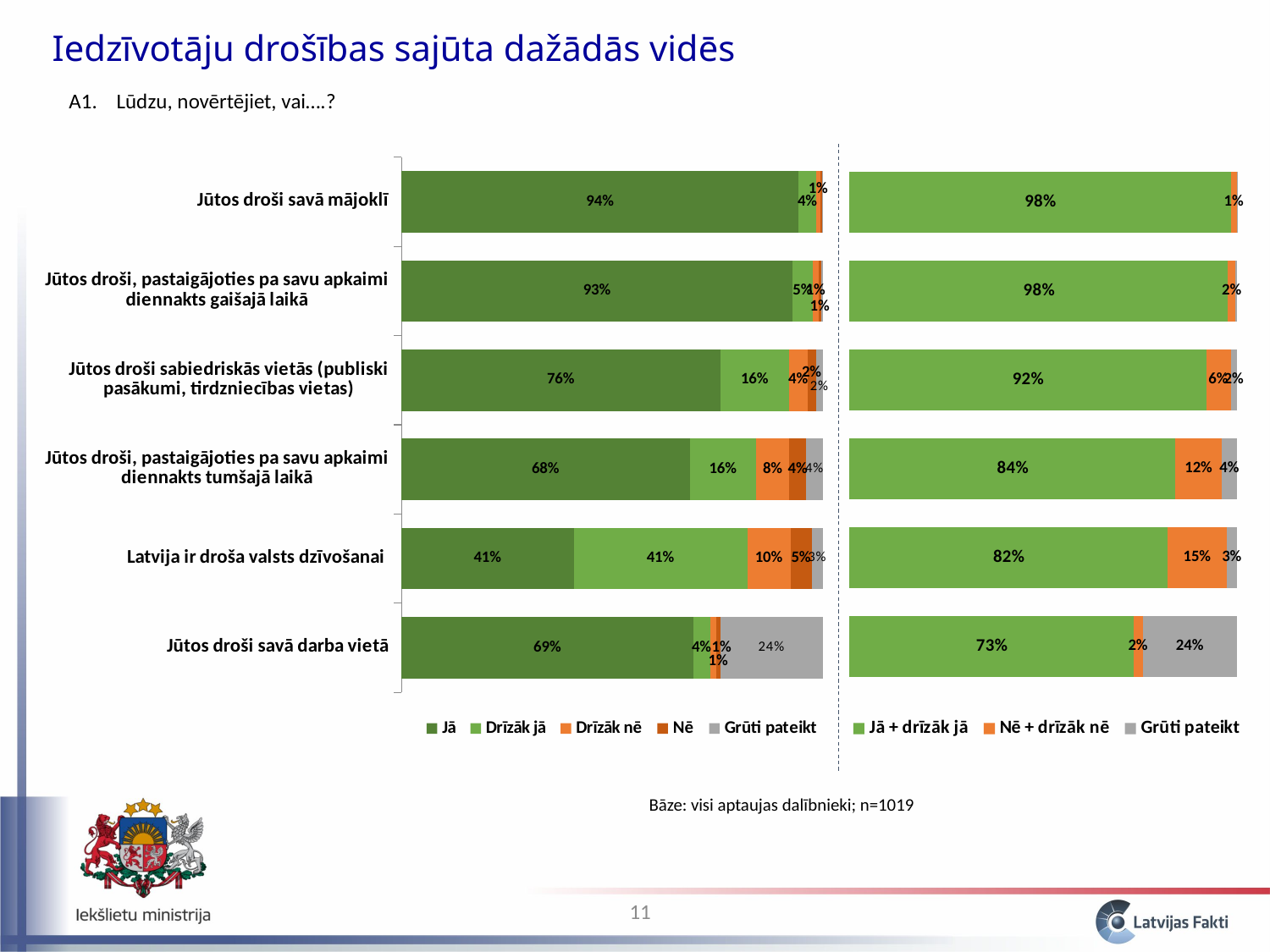
In the left chart, which category has the highest 'Jā' value? Jūtos droši savā mājoklī What kind of chart is the right chart? Stacked bar chart In the right chart, which category has the lowest 'Jā + drīzāk jā' value? Jūtos droši savā darba vietā How many series does the legend of the left chart list? 5 In the left chart, which is larger: the 'Drīzāk jā' value for 'Latvija ir droša valsts dzīvošanai' or for 'Jūtos droši sabiedriskās vietās (publiski pasākumi, tirdzniecības vietas)'? Latvija ir droša valsts dzīvošanai In the right chart, what is the 'Nē + drīzāk nē' value for 'Jūtos droši, pastaigājoties pa savu apkaimi diennakts tumšajā laikā'? 12% In the right chart, what is the 'Jā + drīzāk jā' value for 'Latvija ir droša valsts dzīvošanai'? 82% How many categories are shown in the left chart? 6 How many series does the legend of the right chart list? 3 In the left chart, what is the 'Jā' value for 'Jūtos droši savā mājoklī'? 94% In the left chart, what is the 'Grūti pateikt' value for 'Jūtos droši savā darba vietā'? 24% In the right chart, what is the difference between the 'Jā + drīzāk jā' values for 'Jūtos droši savā mājoklī' and 'Jūtos droši, pastaigājoties pa savu apkaimi diennakts tumšajā laikā'? 14%